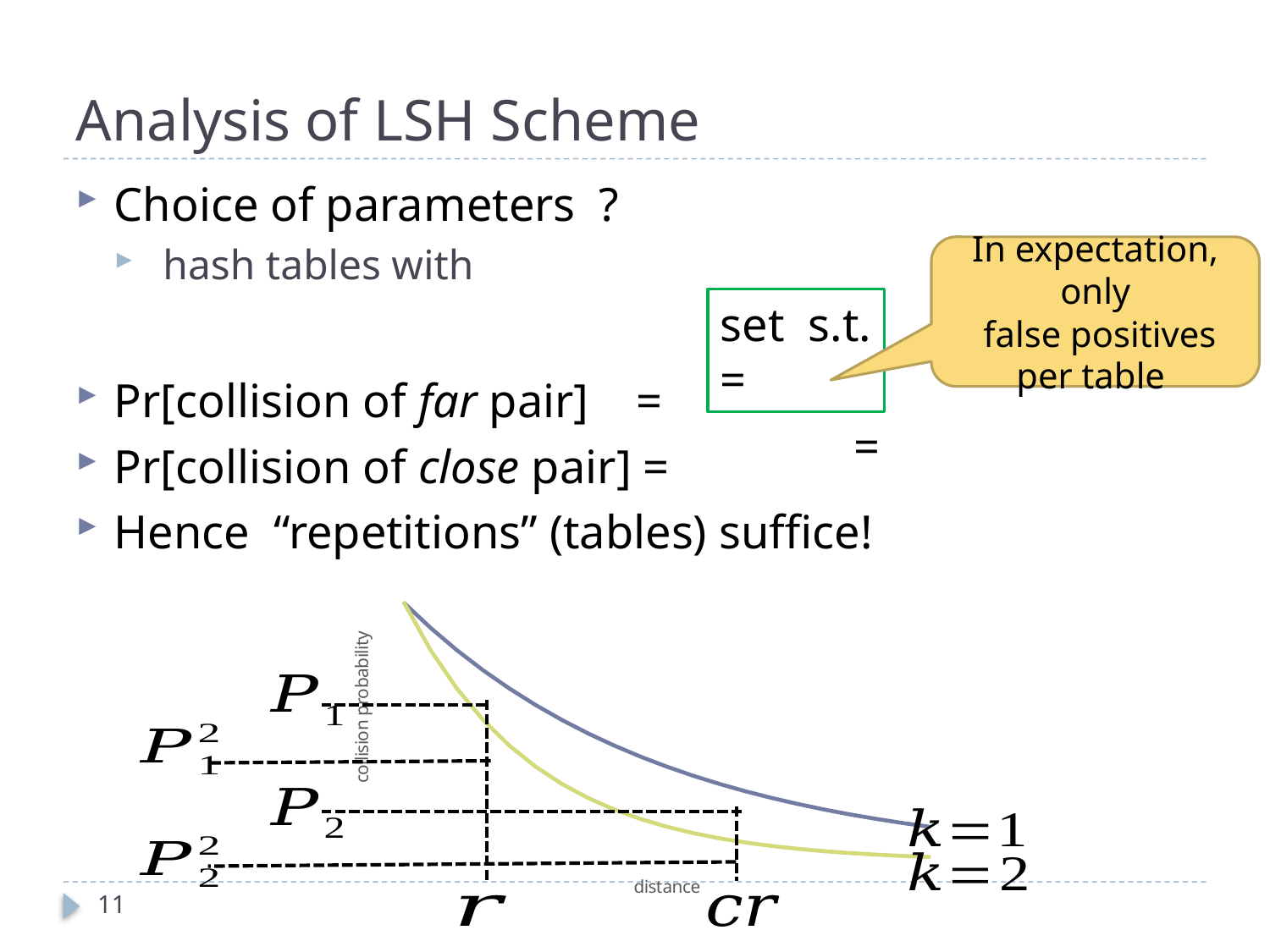
At distance cr, which curve has the lower collision probability, k=1 or k=2? k=2 At distance r, which curve has the higher collision probability, k=1 or k=2? k=1 What kind of chart is shown at the bottom of the slide? line chart Which curve is marked with the value P2 squared at distance cr? k=2 Do the curves in the chart rise or fall as distance increases? fall What is the label of the vertical axis of the chart? collision probability What are the labels of the two curves in the chart? k=1 and k=2 Which curve is drawn in yellow-green, k=1 or k=2? k=2 Which of the two marked distances on the x axis is larger, r or cr? cr Which curve is marked with the value P1 at distance r? k=1 How many curves are plotted in the chart at the bottom of the slide? 2